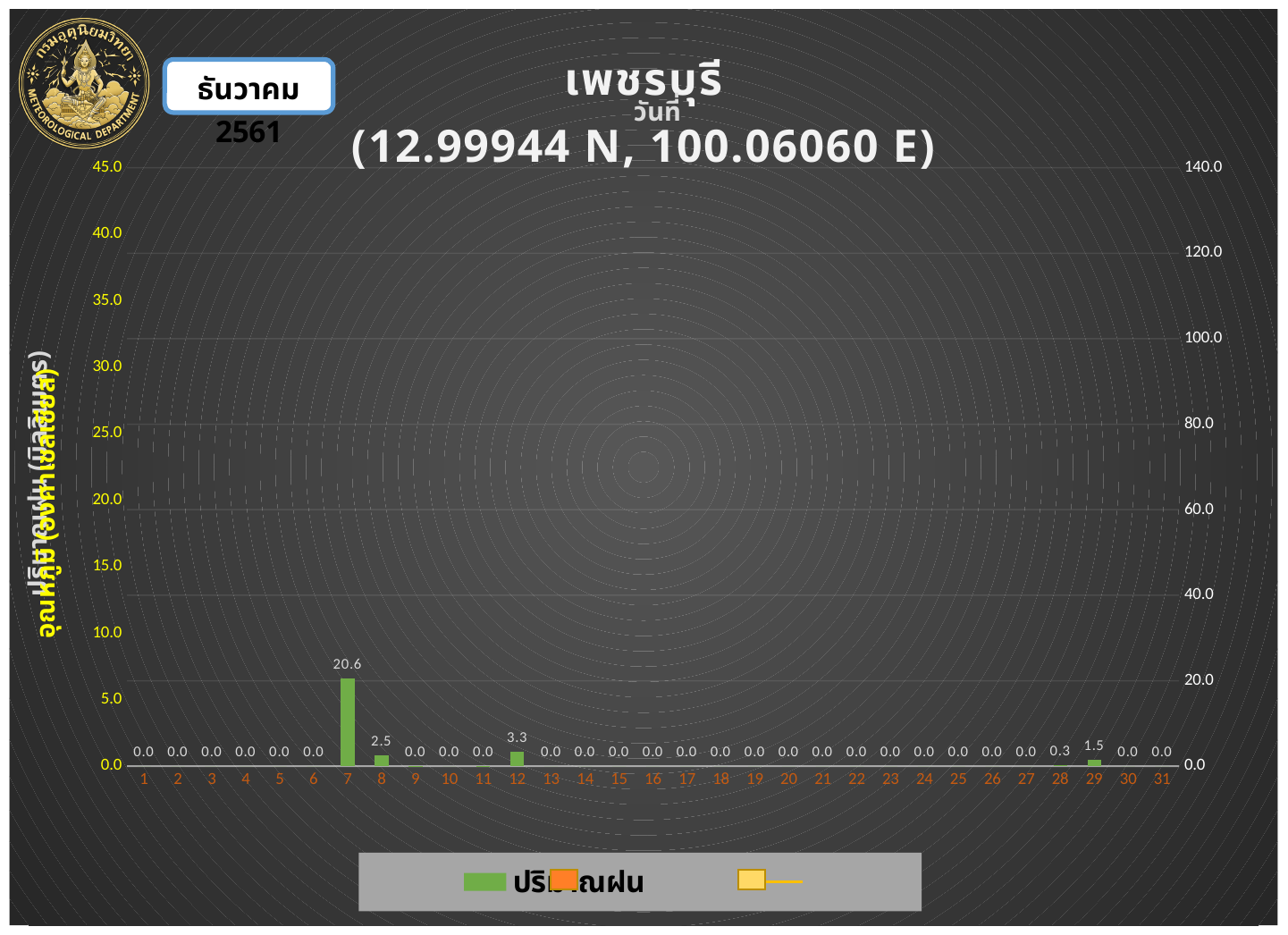
What kind of chart is shown on the slide? bar chart How many days are shown on the x axis? 31 What is the value shown for day 12? 3.3 What is the value shown for day 8? 2.5 What is the rainfall value shown for day 7? 20.6 Is the value for day 7 greater or less than 20.0 on the right axis? greater What is the difference between the values for day 7 and day 12? 17.3 What is the highest tick value shown on the right-hand axis? 140.0 What is the value shown for day 28? 0.3 Which is larger, the value for day 8 or the value for day 12? day 12 Which day has the highest value on the chart? 7 What is the value shown for day 29? 1.5